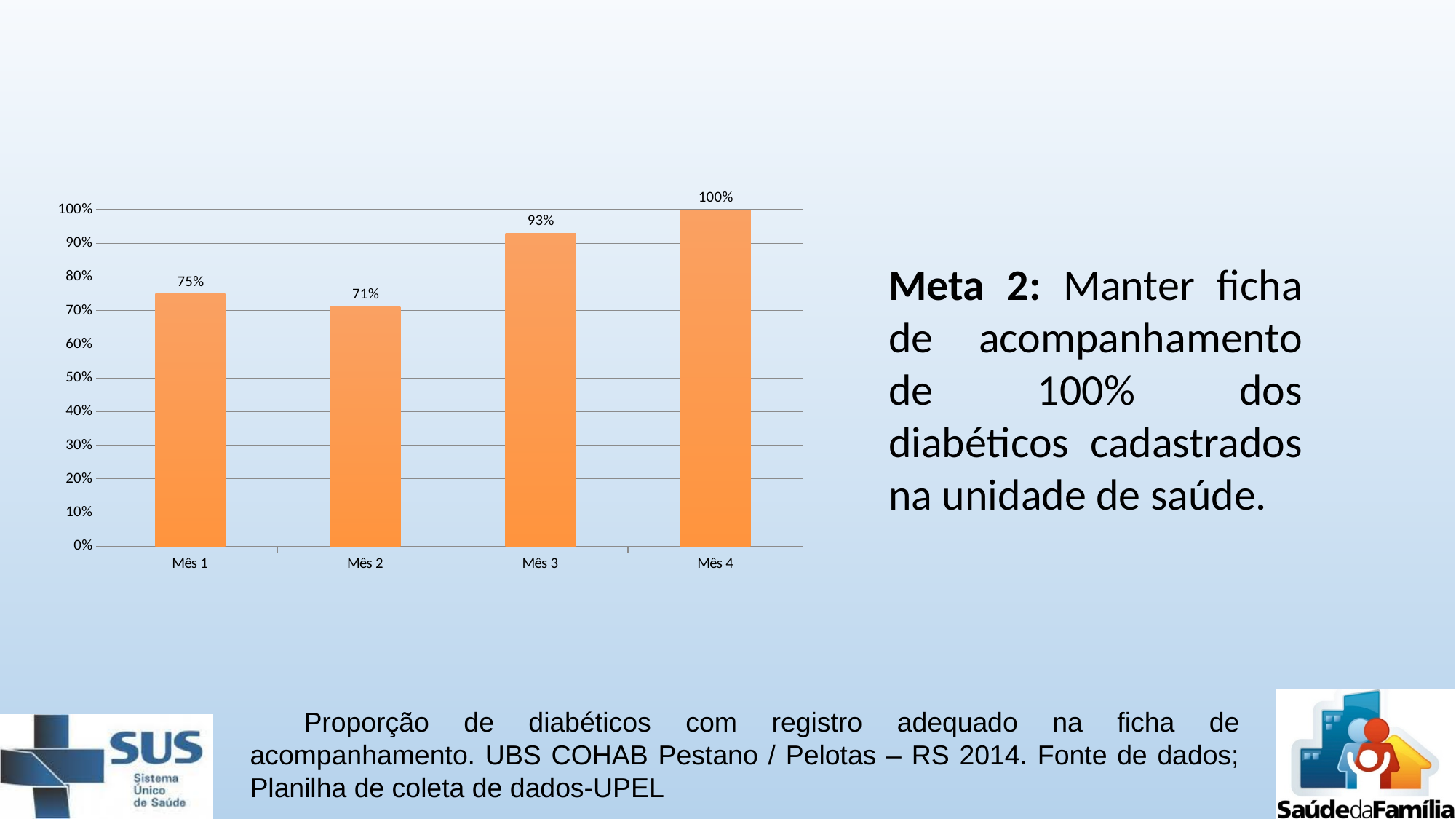
What is the difference between the values for Mês 3 and Mês 2? 22% What is the value for Mês 4? 100% What is the value for Mês 3? 93% What is the value for Mês 1? 75% What is the difference between the values for Mês 4 and Mês 1? 25% What kind of chart is shown on the slide? Bar chart Which is larger, the value for Mês 1 or the value for Mês 2? Mês 1 Which month has the highest value? Mês 4 How many months are shown on the x axis? 4 What is the value for Mês 2? 71% Which month has the lowest value? Mês 2 What colour are the bars in the chart? Orange